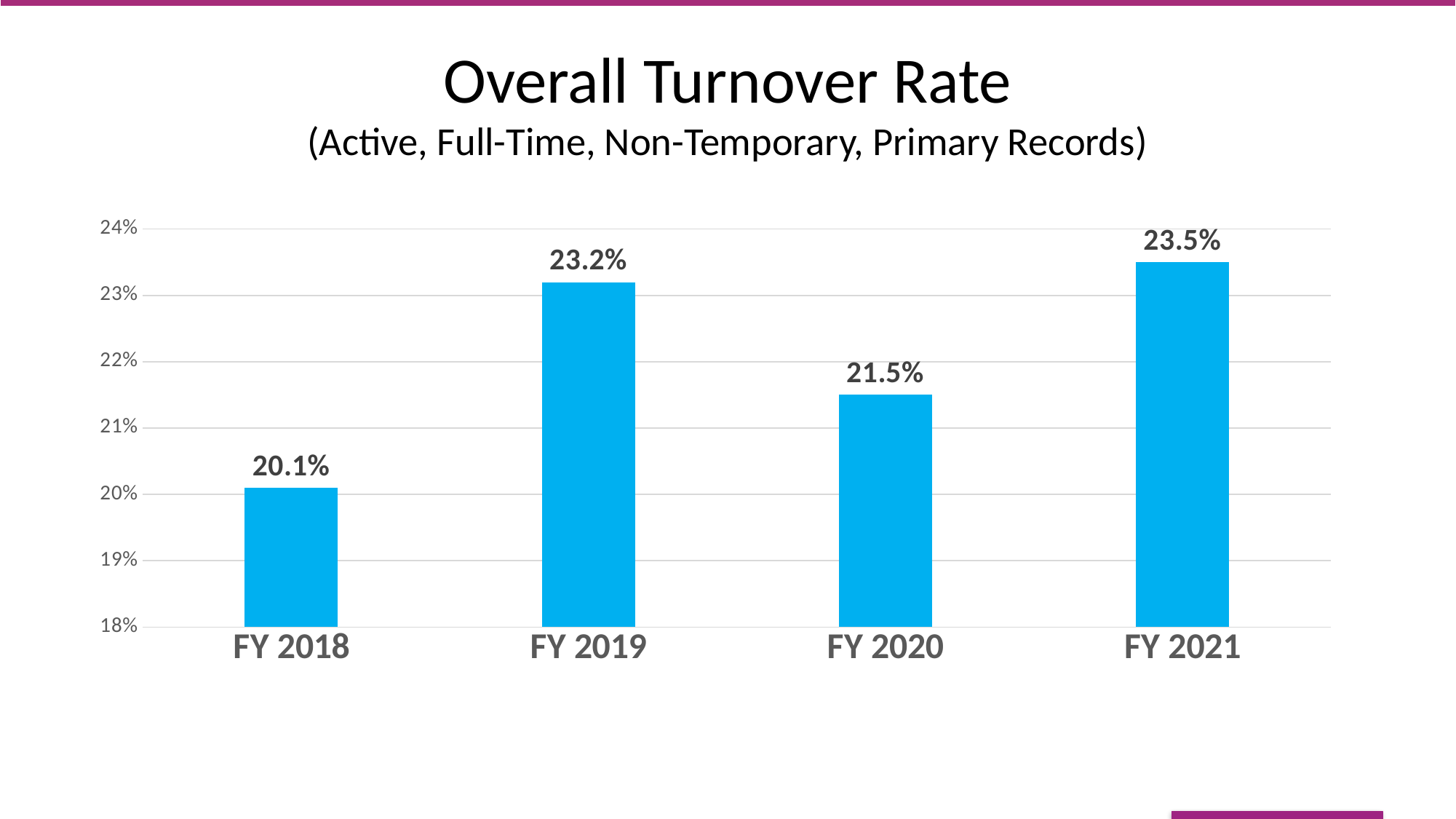
What is the title of the chart? Overall Turnover Rate What kind of chart is shown on the slide? Bar chart Which fiscal year has the lowest overall turnover rate? FY 2018 How many fiscal years are shown in the chart? 4 What is the overall turnover rate for FY 2018? 20.1% Which fiscal year has the highest overall turnover rate? FY 2021 By how much did the turnover rate increase from FY 2018 to FY 2021? 3.4% Which has a higher turnover rate, FY 2019 or FY 2020? FY 2019 What is the overall turnover rate for FY 2021? 23.5% What is the difference in turnover rate between FY 2019 and FY 2020? 1.7% Is the turnover rate for FY 2020 greater or less than 22%? less What is the overall turnover rate for FY 2020? 21.5%